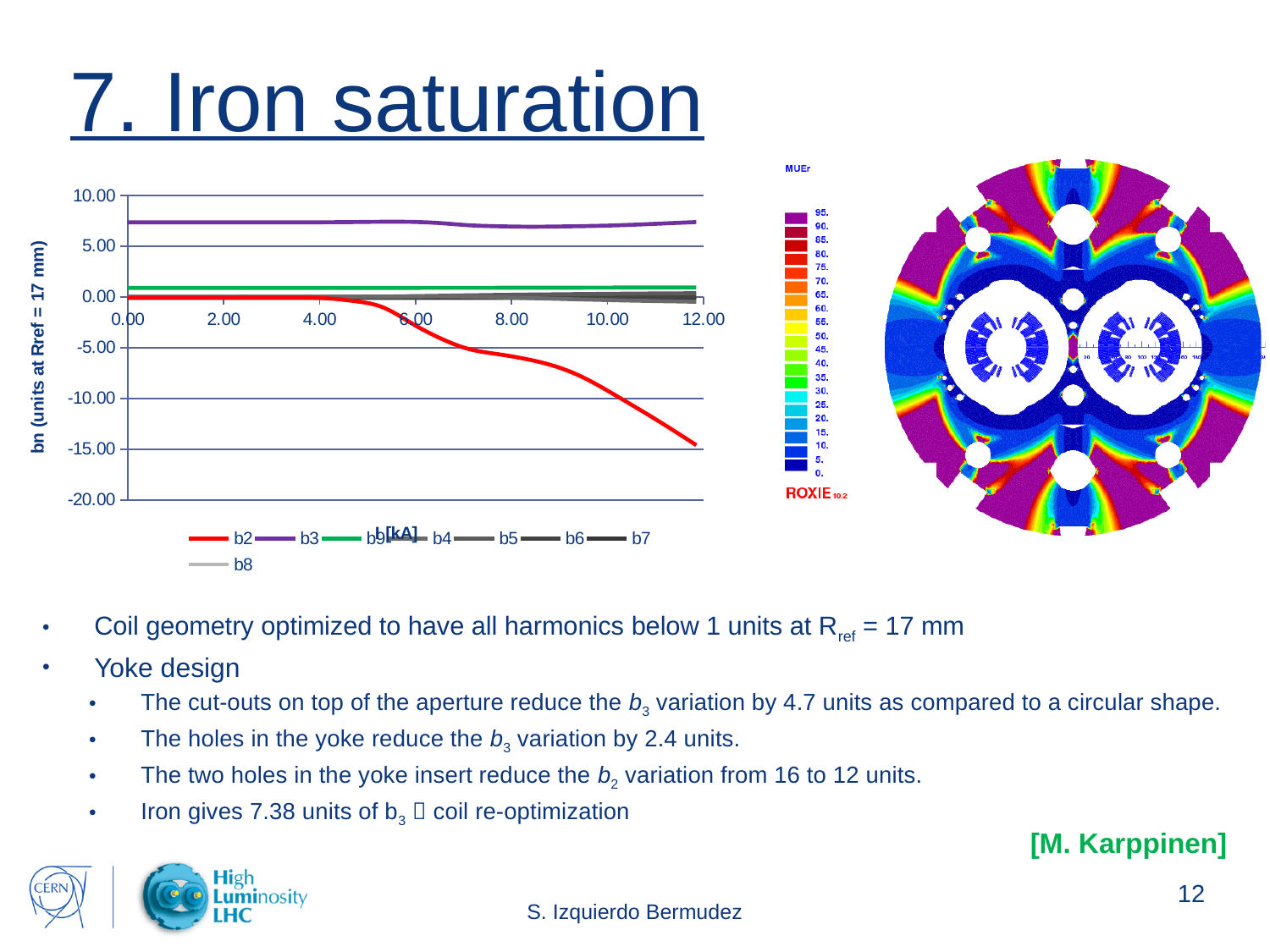
In the line chart, is the value of b3 at 0 kA greater or less than 5.00? greater In the line chart, which is larger at 10 kA, b2 or b3? b3 In the line chart, which series has the lowest value at 12 kA? b2 What colour is the b2 series in the line chart? red What is the y-axis title of the line chart? bn (units at Rref = 17 mm) In the line chart, is the value of b2 at 12 kA greater or less than -10? less What kind of chart is shown on the left of the slide? line chart In the line chart, is the value of b3 at 8 kA greater or less than 10.00? less In the line chart, does the b2 series rise or fall as the current increases from 6 kA to 12 kA? fall In the line chart, which series has the highest value at 12 kA? b3 How many series does the legend of the line chart list? 8